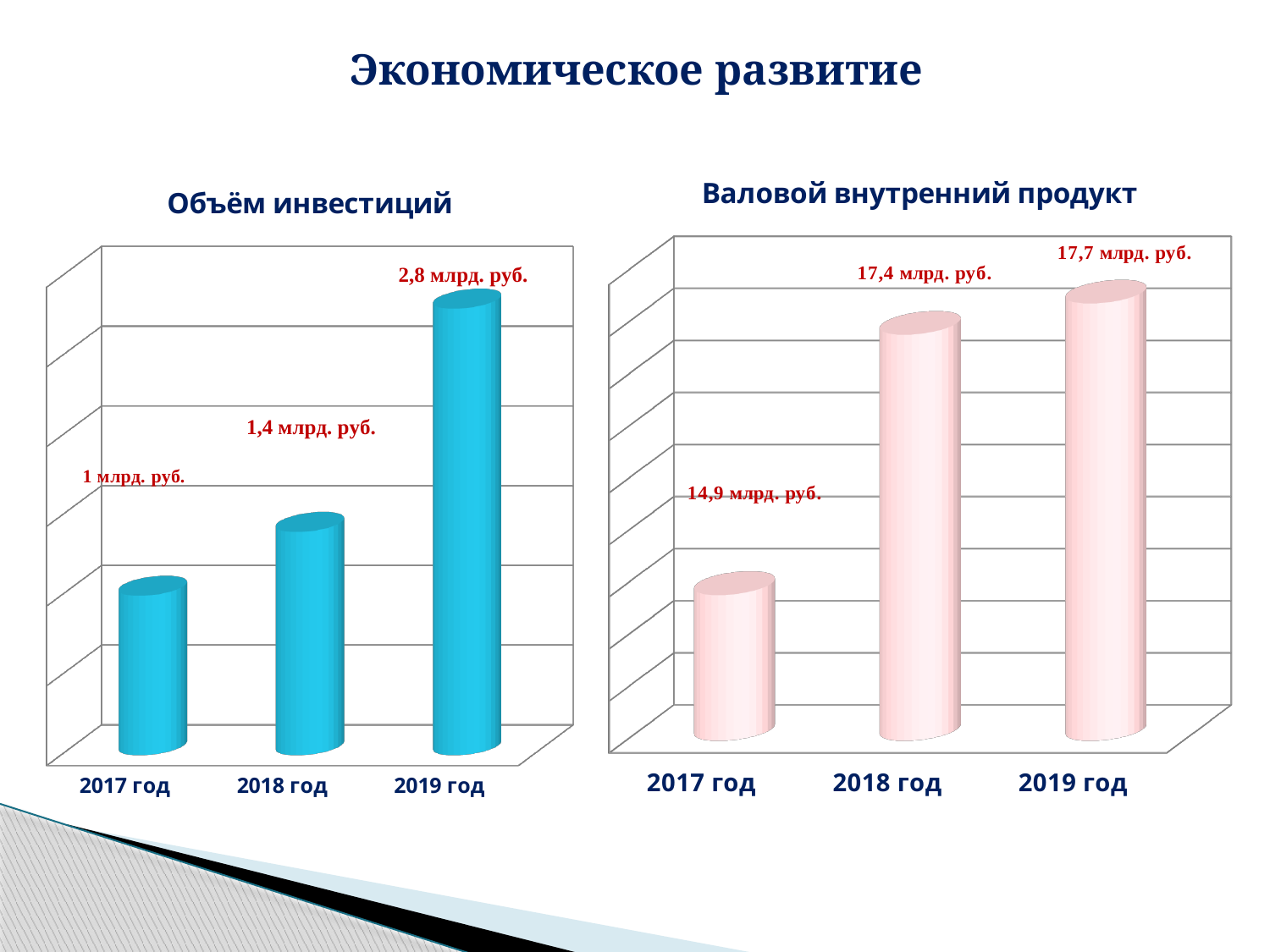
In the chart titled "Валовой внутренний продукт", what is the value for 2017 год? 14,9 млрд. руб. In the chart titled "Валовой внутренний продукт", what is the value for 2018 год? 17,4 млрд. руб. In the chart titled "Валовой внутренний продукт", which year has the lowest value? 2017 год How many years are shown in the chart titled "Объём инвестиций"? 3 In the chart titled "Объём инвестиций", what is the value for 2019 год? 2,8 млрд. руб. In the chart titled "Объём инвестиций", do the values rise or fall from 2017 год to 2019 год? rise In the chart titled "Объём инвестиций", which year has the highest value? 2019 год In the chart titled "Валовой внутренний продукт", which is larger: the value for 2018 год or 2019 год? 2019 год What kind of chart is the chart titled "Валовой внутренний продукт"? bar chart In the chart titled "Объём инвестиций", what is the difference between the values for 2019 год and 2018 год? 1,4 млрд. руб. In the chart titled "Валовой внутренний продукт", what is the difference between the values for 2019 год and 2017 год? 2,8 млрд. руб. In the chart titled "Объём инвестиций", what is the value for 2017 год? 1 млрд. руб.